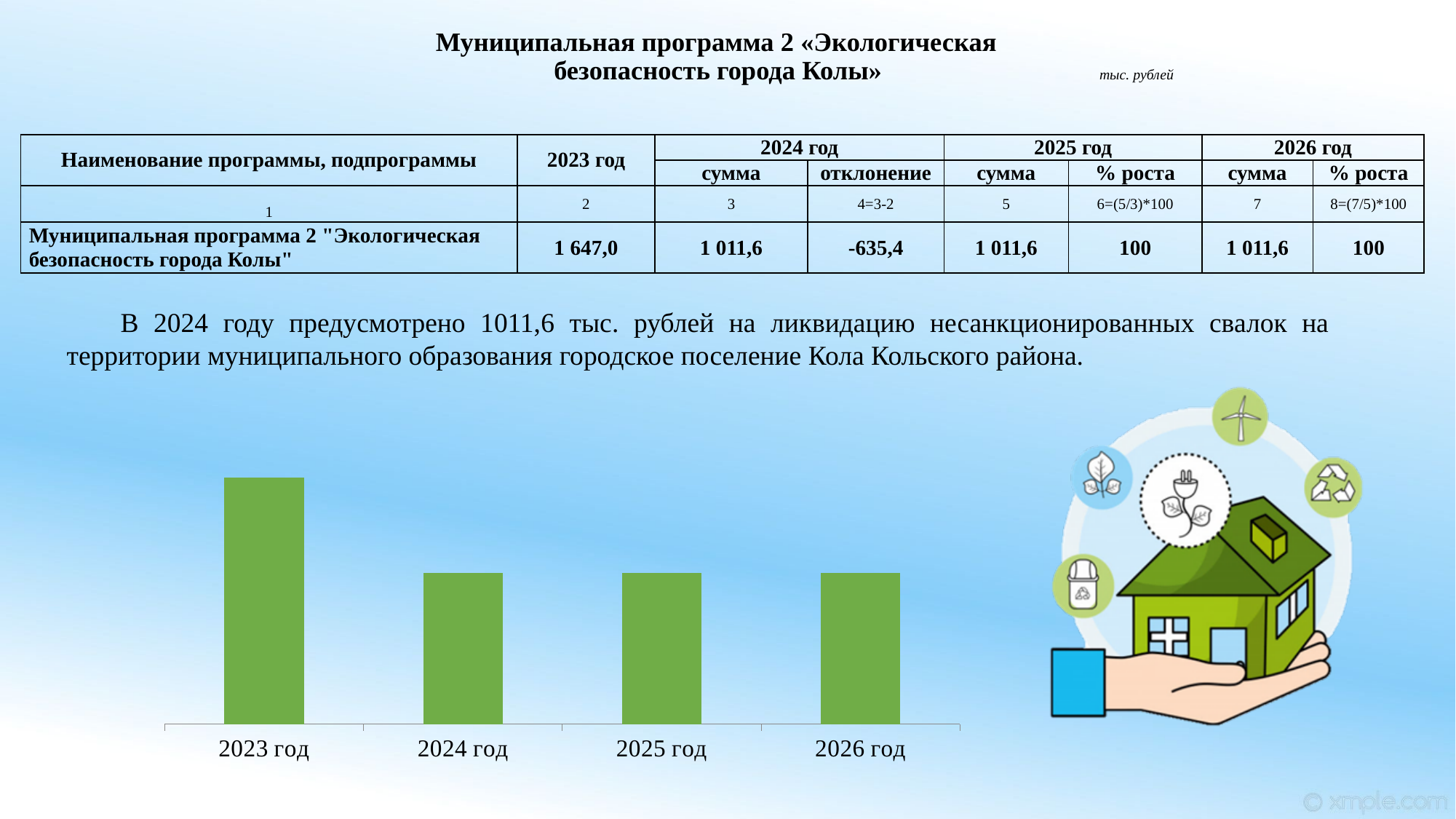
How many bars (categories) does the chart show? 4 Do the bar values rise or fall from 2023 год to 2024 год? fall Are the bars for 2024 год, 2025 год and 2026 год the same height or different heights? the same height What kind of chart is shown on the slide? bar chart Which bar is taller, 2023 год or 2024 год? 2023 год Which year has the highest bar in the chart? 2023 год Which bar is taller, 2023 год or 2026 год? 2023 год What is the first category on the x axis of the chart? 2023 год What colour are the bars in the chart? green